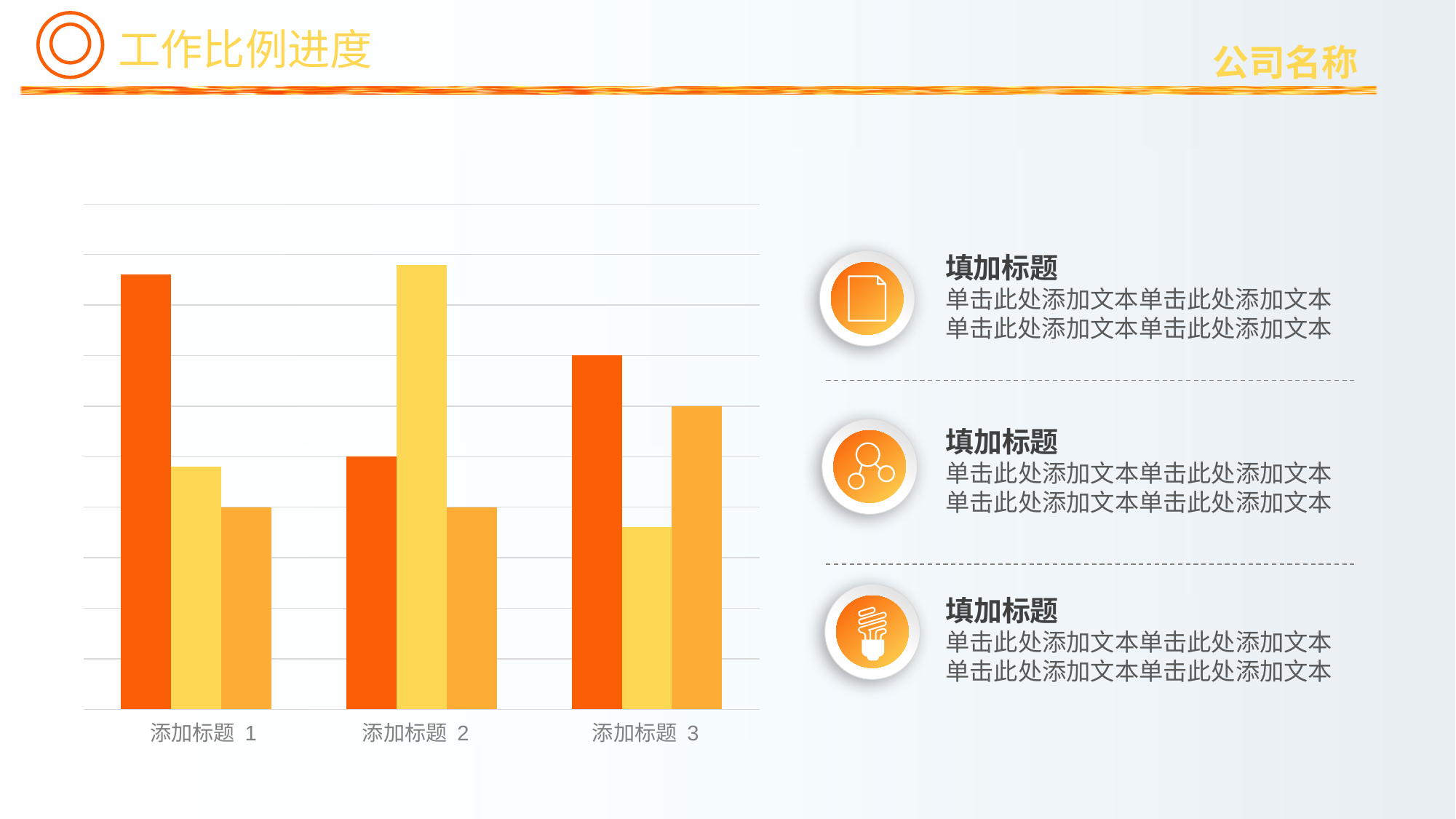
Which category has the shortest dark orange bar? 添加标题 2 Is the dark orange bar taller for 添加标题 1 or for 添加标题 3? 添加标题 1 What kind of chart is shown on the slide? bar chart How many bars are plotted in the chart in total? 9 In the category 添加标题 3, which coloured bar is the shortest? yellow How many categories are shown on the x axis of the chart? 3 Which category has the tallest yellow bar? 添加标题 2 In the category 添加标题 1, which coloured bar is the tallest? dark orange Does the chart display a legend? No Which category has the tallest light orange bar? 添加标题 3